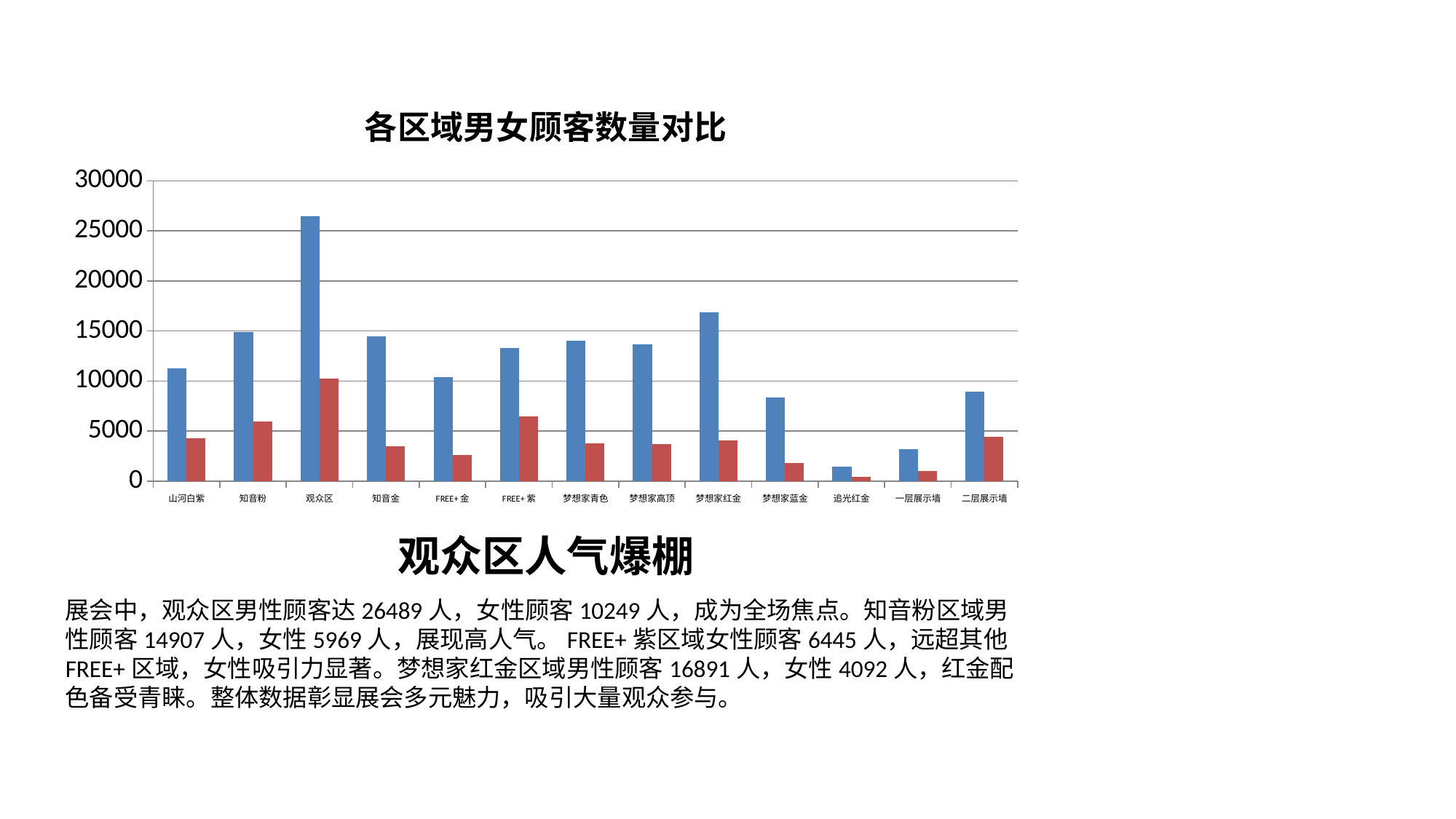
Is the blue bar for 梦想家蓝金 greater or less than 10000? less Is the blue bar for 山河白紫 greater or less than 10000? greater Is the blue bar for 一层展示墙 greater or less than 5000? less Which region has the tallest red bar in the chart? 观众区 Which region has a taller blue bar, 梦想家红金 or 知音粉? 梦想家红金 Which region has the tallest blue bar in the chart? 观众区 Which region has the shortest blue bar in the chart? 追光红金 How many regions (categories) are shown on the x axis of the chart? 13 What is the title of the chart? 各区域男女顾客数量对比 What type of chart is shown on the slide? bar chart According to the slide, how many male customers did 观众区 have? 26489 According to the slide, what is the difference between male and female customers in 观众区? 16240